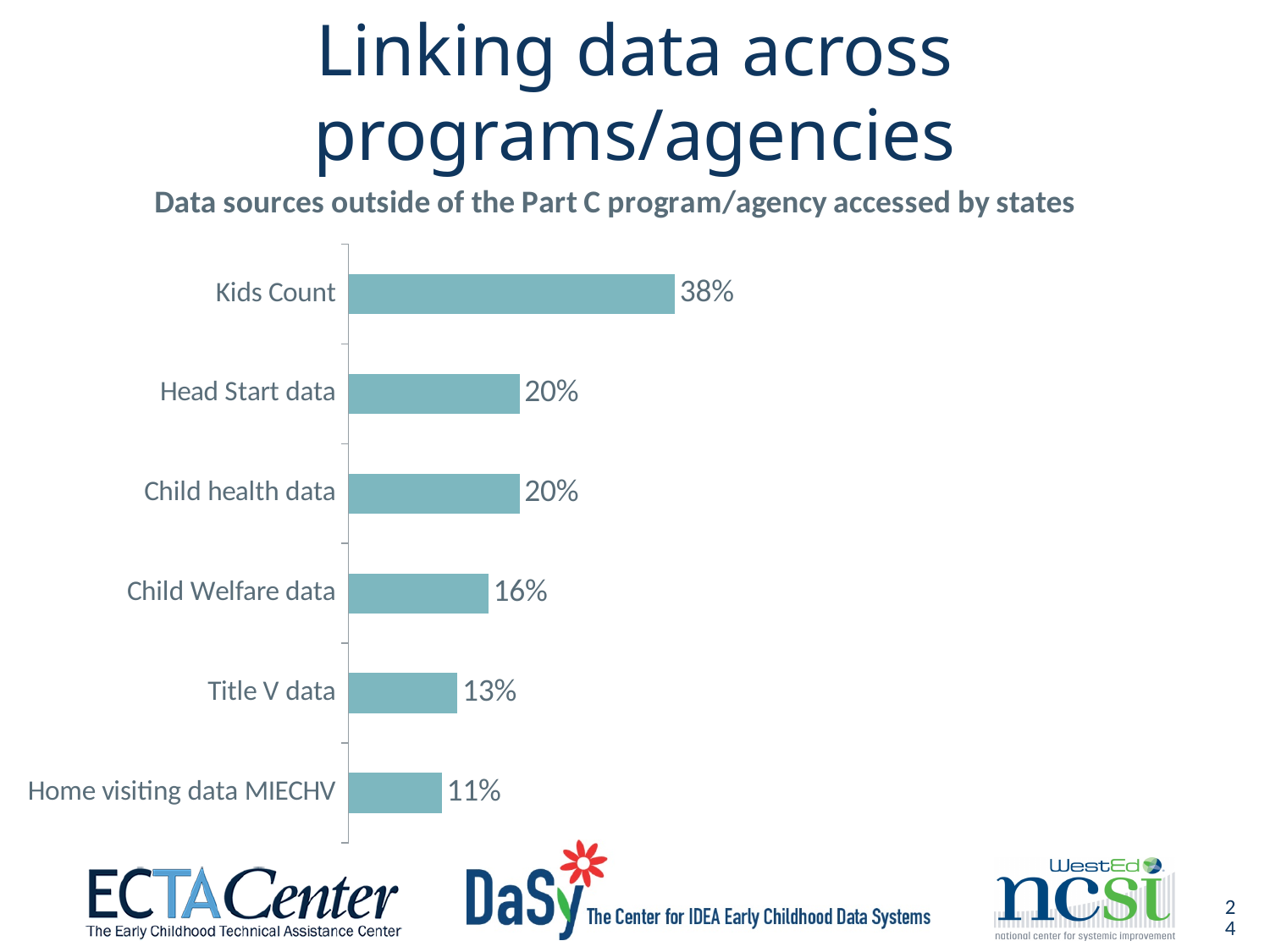
What percentage of states accessed Kids Count data? 38% Which data source has the highest percentage? Kids Count Which data source has the lowest percentage? Home visiting data MIECHV Which is larger, the value for Child Welfare data or the value for Child health data? Child health data What is the value shown for Title V data? 13% What is the value shown for Home visiting data MIECHV? 11% What kind of chart is shown on the slide? Bar chart What is the difference between the values for Child Welfare data and Title V data? 3% How many data sources are shown in the chart? 6 Which two data sources share the same value of 20%? Head Start data and Child health data What is the difference between the values for Kids Count and Head Start data? 18% What is the title of the chart? Data sources outside of the Part C program/agency accessed by states